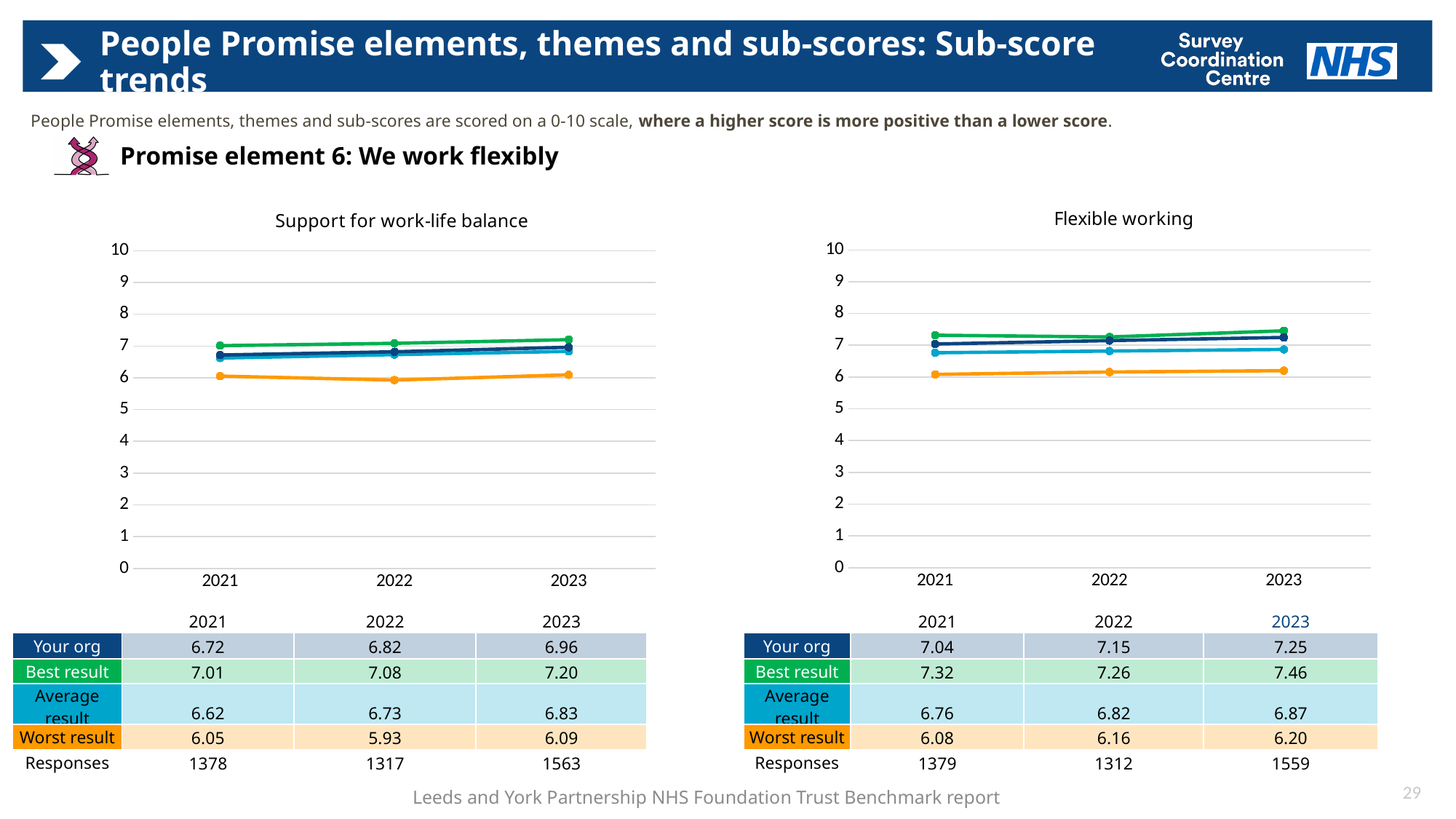
How many years are shown on the x axis of the 'Flexible working' chart? 3 In the 'Support for work-life balance' chart, what is the 'Worst result' value for 2022? 5.93 In the 'Support for work-life balance' chart, which is larger in 2021: the 'Your org' value or the 'Average result' value? Your org In the 'Flexible working' chart, what is the difference between the 'Best result' and 'Your org' values for 2023? 0.21 In the 'Support for work-life balance' chart, in which year is the 'Worst result' value lowest? 2022 In the 'Support for work-life balance' chart, what is the 'Your org' value for 2023? 6.96 In the 'Flexible working' chart, is the 'Worst result' value for 2023 greater or less than 7? less What kind of chart is the 'Support for work-life balance' chart? line chart In the 'Support for work-life balance' chart, in which year is the 'Your org' value highest? 2023 In the 'Flexible working' chart, what is the 'Best result' value for 2023? 7.46 In the 'Flexible working' chart, does the 'Your org' line rise or fall from 2021 to 2023? rise In the 'Flexible working' chart, what is the 'Average result' value for 2021? 6.76